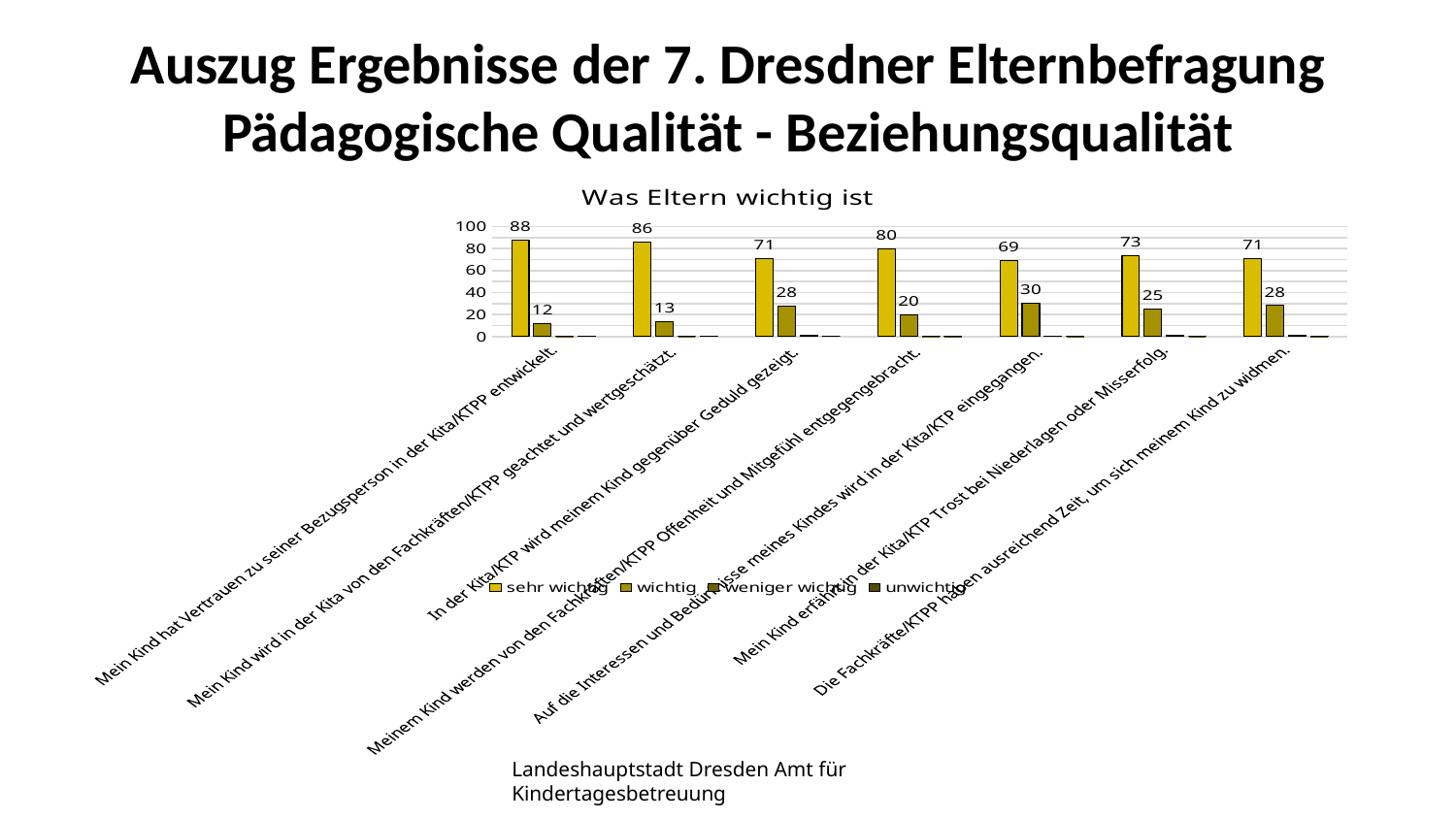
What is the difference between the 'sehr wichtig' and 'wichtig' values for 'Meinem Kind werden von den Fachkräften/KTPP Offenheit und Mitgefühl entgegengebracht.'? 60 Which category has the lowest 'sehr wichtig' value? Auf die Interessen und Bedürfnisse meines Kindes wird in der Kita/KTP eingegangen. What kind of chart is shown on the slide? bar chart What is the 'sehr wichtig' value for 'Mein Kind erfährt in der Kita/KTP Trost bei Niederlagen oder Misserfolg.'? 73 Is the 'sehr wichtig' value for 'Die Fachkräfte/KTPP haben ausreichend Zeit, um sich meinem Kind zu widmen.' greater or less than 60? greater How many series does the legend list? 4 How many categories are shown on the x axis? 7 Which category has the highest 'sehr wichtig' value? Mein Kind hat Vertrauen zu seiner Bezugsperson in der Kita/KTPP entwickelt. What is the title of the chart? Was Eltern wichtig ist What is the 'wichtig' value for 'Auf die Interessen und Bedürfnisse meines Kindes wird in der Kita/KTP eingegangen.'? 30 What is the 'sehr wichtig' value for 'Mein Kind hat Vertrauen zu seiner Bezugsperson in der Kita/KTPP entwickelt.'? 88 Which is larger: the 'wichtig' value for 'Mein Kind wird in der Kita von den Fachkräften/KTPP geachtet und wertgeschätzt.' or for 'In der Kita/KTP wird meinem Kind gegenüber Geduld gezeigt.'? In der Kita/KTP wird meinem Kind gegenüber Geduld gezeigt.